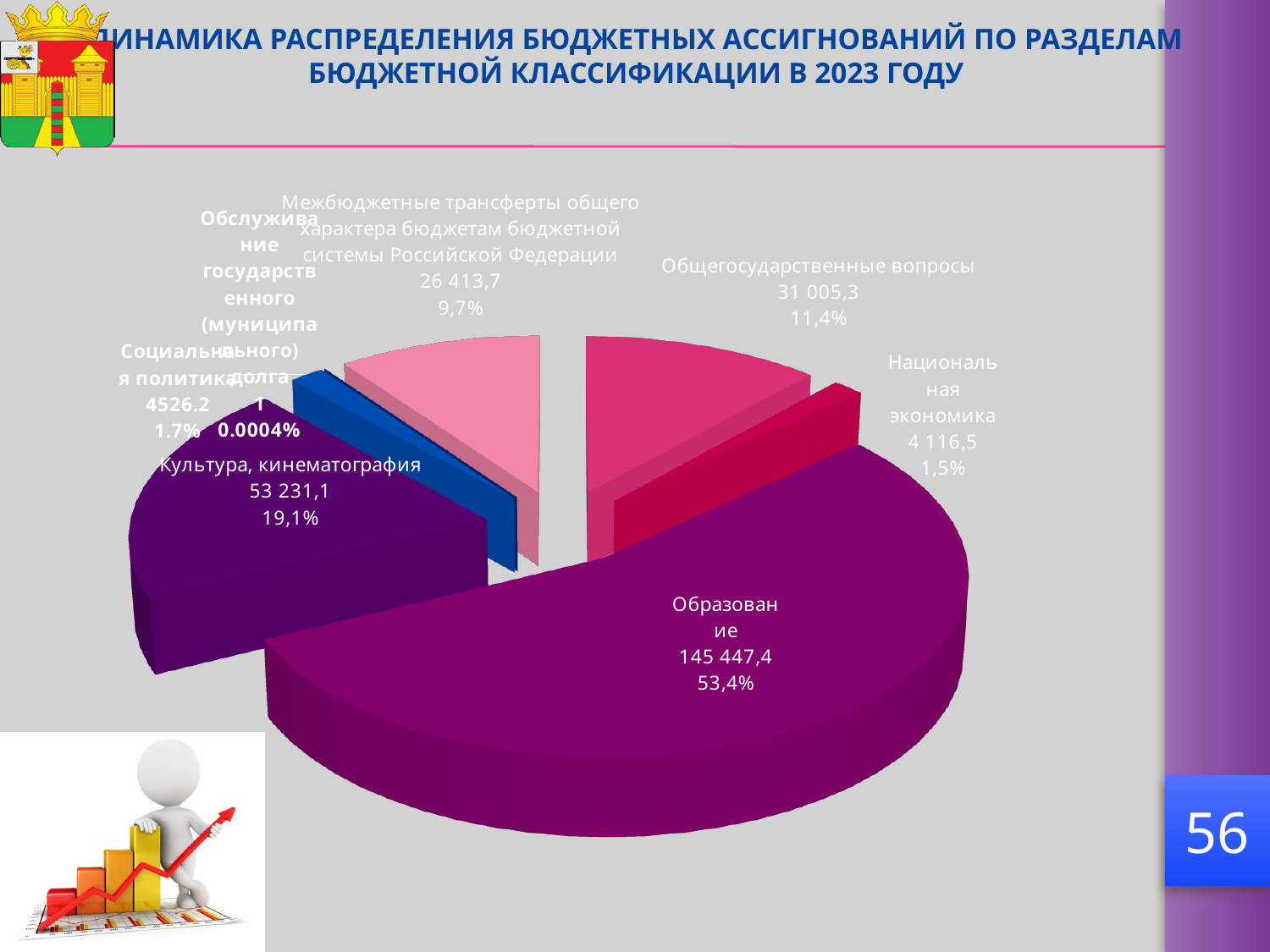
What is the difference in percentage points between Образование (53,4%) and Культура, кинематография (19,1%)? 34,3 What is the value shown for Культура, кинематография? 53 231,1 What is the value shown for Образование? 145 447,4 Which is larger: Общегосударственные вопросы or Национальная экономика? Общегосударственные вопросы What share of the pie does Образование represent? 53,4% How many categories (slices) does the pie chart show? 7 What percentage is shown for Общегосударственные вопросы? 11,4% What kind of chart is shown on the slide? pie chart Which category has the smallest slice of the pie? Обслуживание государственного (муниципального) долга What percentage is shown for Межбюджетные трансферты общего характера бюджетам бюджетной системы Российской Федерации? 9,7% Which category has the largest slice of the pie? Образование What is the value shown for Национальная экономика? 4 116,5